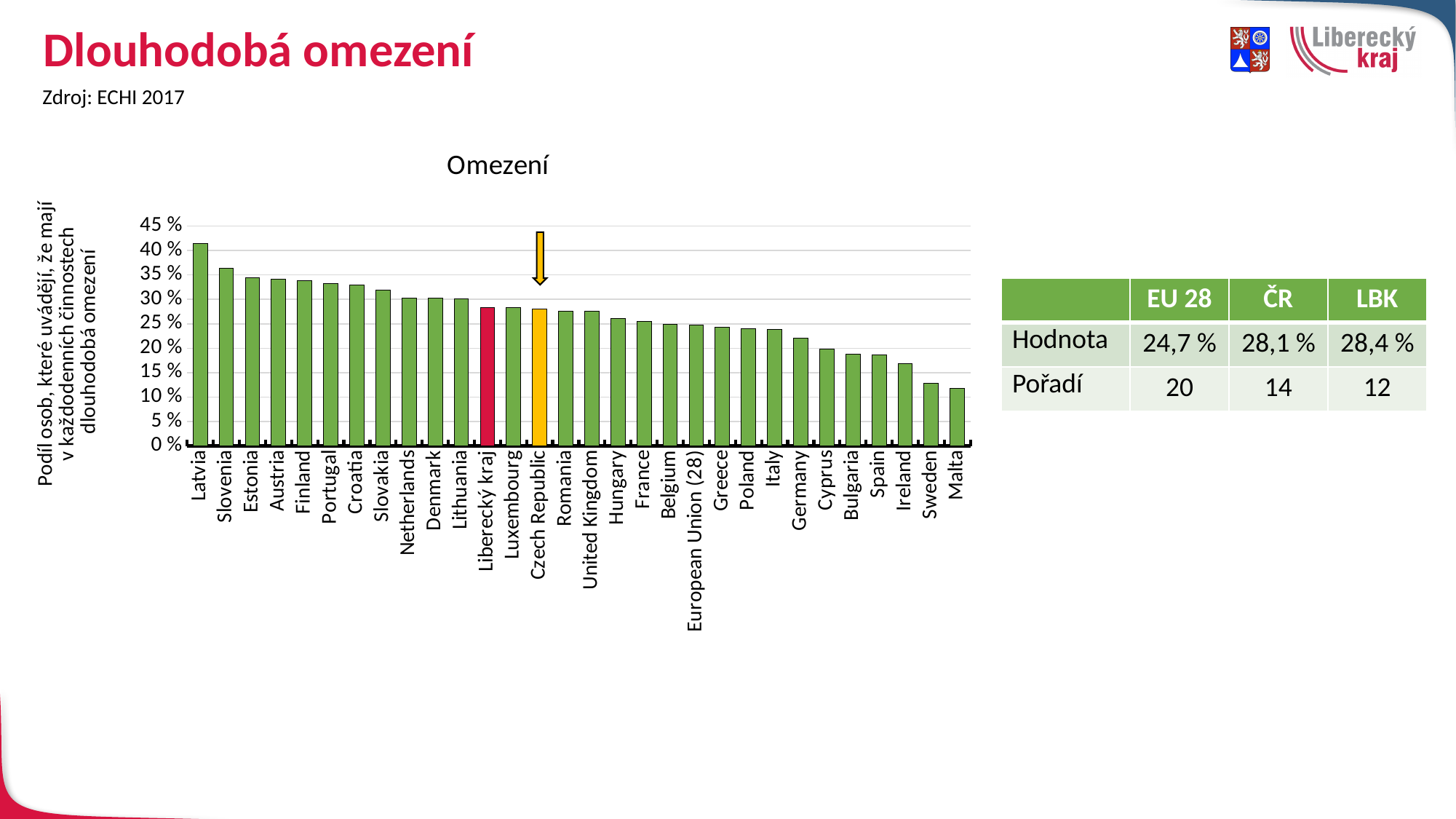
How many categories (bars) are plotted in the chart? 30 Is the value for Latvia greater or less than 40 %? greater Which is larger, the value for Latvia or the value for Slovenia? Latvia Which category has the lowest value in the chart? Malta Is the value for Malta greater or less than 15 %? less According to the table on the slide, what is the value (Hodnota) for LBK? 28,4 % What is the title of the chart? Omezení What kind of chart is shown on the slide? bar chart Is the value for Germany greater or less than 20 %? greater Which category has the highest value in the chart? Latvia Do the values rise or fall moving from left to right along the x axis? fall What colour is the bar for Czech Republic? yellow